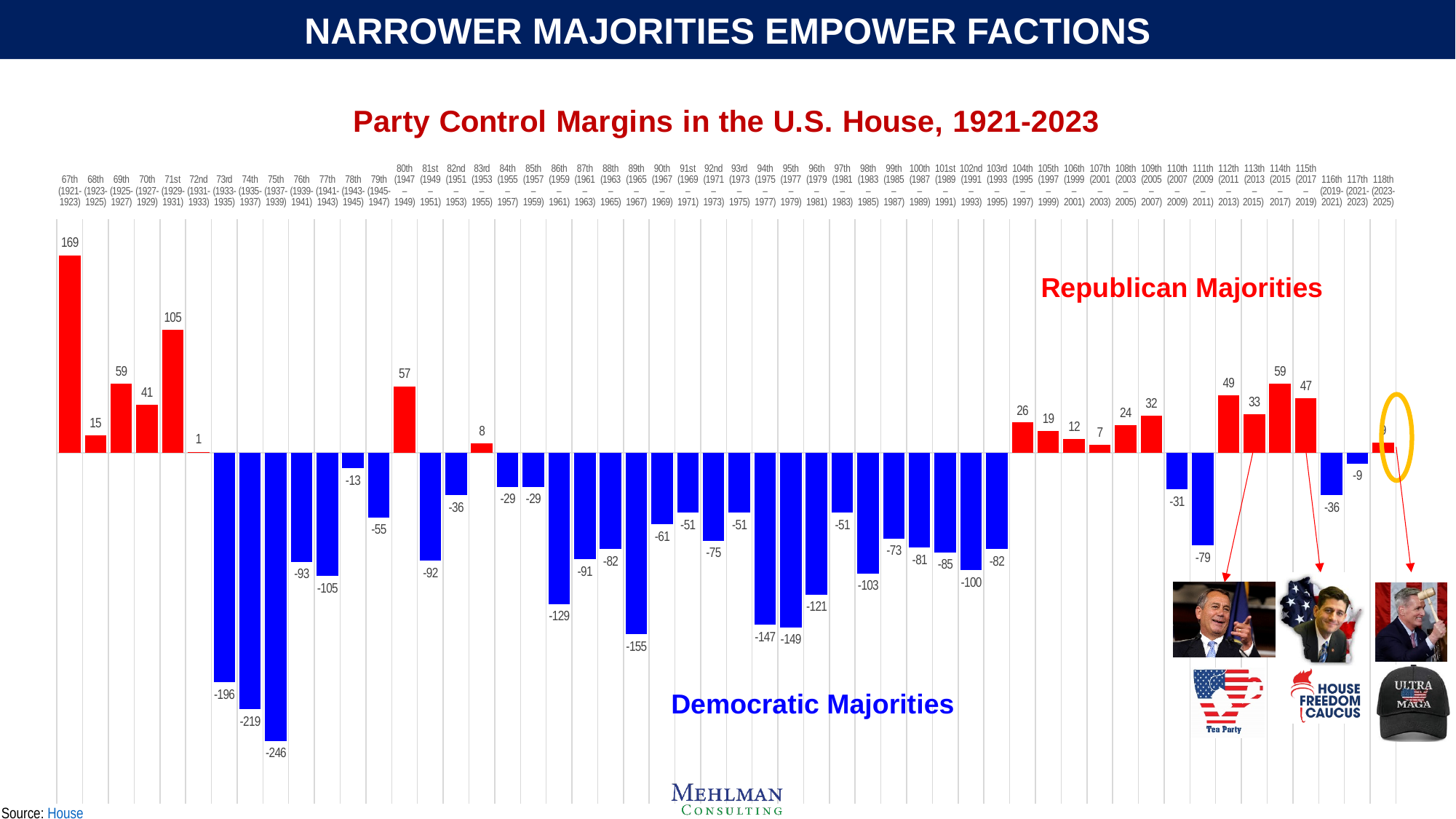
Which Congress has the largest Republican majority margin in the chart? 67th (1921-1923) What is the margin shown for the 80th Congress (1947-1949)? 57 By how much does the Democratic margin of the 75th Congress (-246) exceed that of the 74th Congress (-219) in absolute size? 27 What is the margin shown for the 104th Congress (1995-1997)? 26 What kind of chart is used to show the party control margins? Bar chart What colour are the bars representing Republican majorities? Red Which has the larger Republican margin, the 112th Congress or the 114th Congress? 114th Congress How many Congresses are plotted in the chart? 52 What is the margin shown for the 111th Congress (2009-2011)? -79 What is the difference between the margins of the 67th Congress (169) and the 71st Congress (105)? 64 What is the party control margin shown for the 67th Congress (1921-1923)? 169 Which Congress has the largest Democratic majority margin (the most negative value) in the chart? 75th (1937-1939)